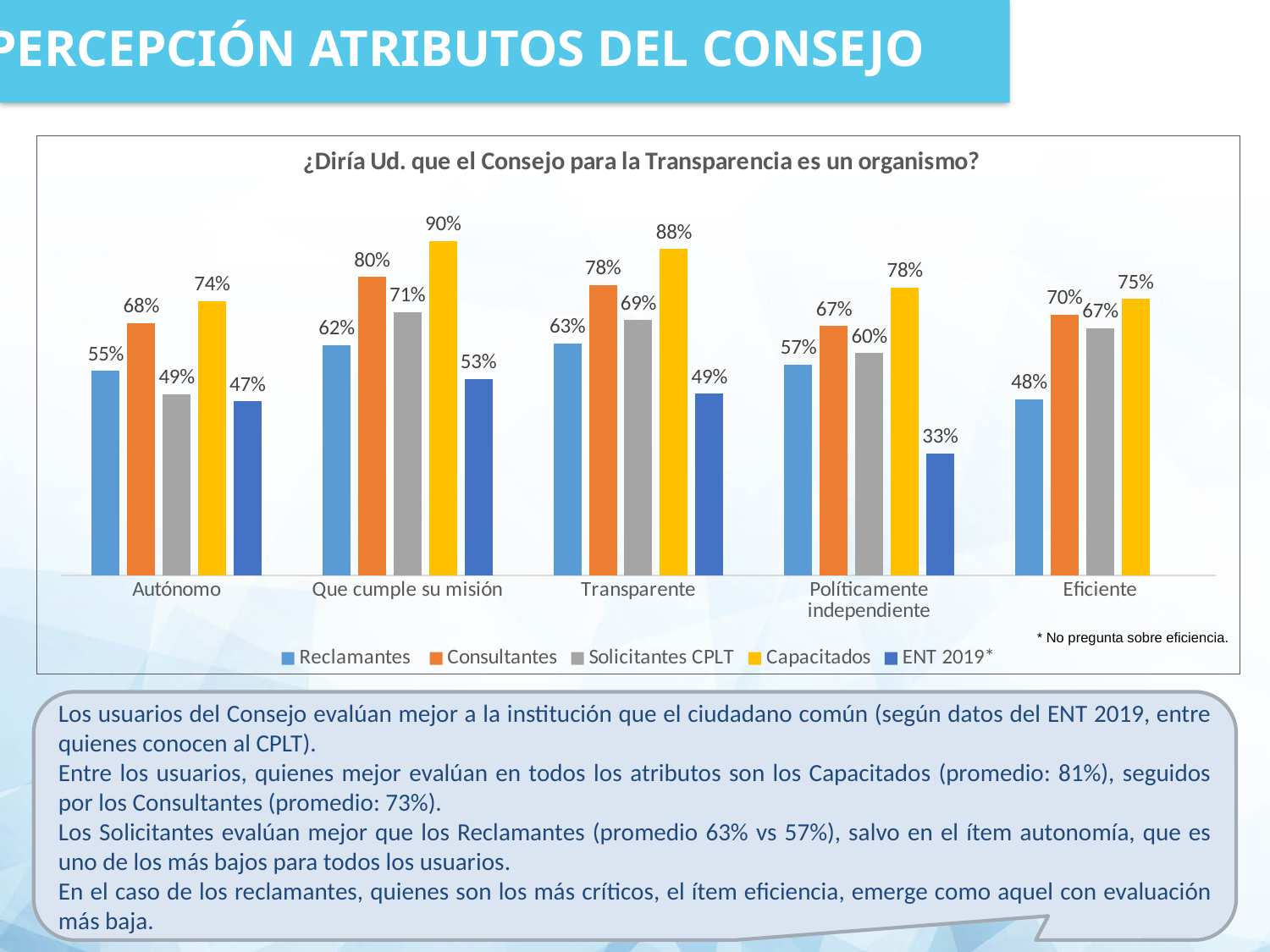
What is the value for Solicitantes CPLT in the category 'Autónomo'? 49% Which category has the highest value for the Reclamantes series? Transparente What type of chart is shown on the slide? bar chart Which series has the lowest value in the category 'Eficiente'? Reclamantes What is the value for Capacitados in the category 'Que cumple su misión'? 90% How many series does the chart legend list? 5 What is the value for ENT 2019* in the category 'Políticamente independiente'? 33% What is the title of the chart? ¿Diría Ud. que el Consejo para la Transparencia es un organismo? What is the difference between the Capacitados and Reclamantes values in the category 'Transparente'? 25% In the category 'Autónomo', which is larger: the value for Consultantes or the value for Capacitados? Capacitados How many categories are shown on the x axis of the chart? 5 Which series has no bar in the category 'Eficiente'? ENT 2019*